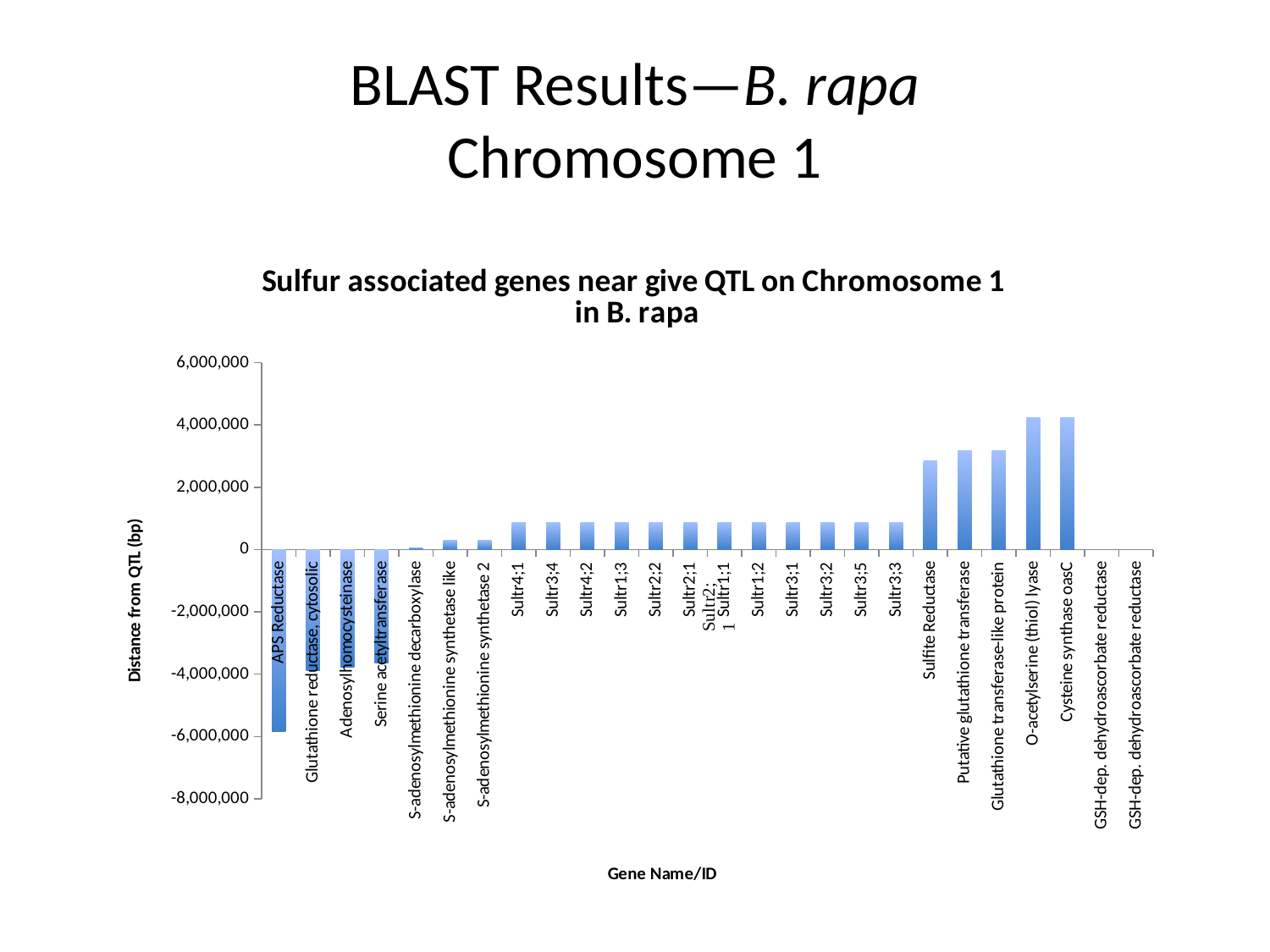
Is the value for APS Reductase greater or less than -4,000,000? less Which gene has the lowest (most negative) distance from the QTL? APS Reductase Is the value for Glutathione reductase, cytosolic greater or less than -2,000,000? less What is the title of the chart? Sulfur associated genes near give QTL on Chromosome 1 in B. rapa Is the value for Sulfite Reductase greater or less than 2,000,000? greater Which has the larger value, Sulfite Reductase or Putative glutathione transferase? Putative glutathione transferase What is the label of the vertical axis? Distance from QTL (bp) What kind of chart is shown on the slide? bar chart Which has the larger value, APS Reductase or Serine acetyltransferase? Serine acetyltransferase Do the bar values generally rise or fall moving from left to right along the x axis? rise